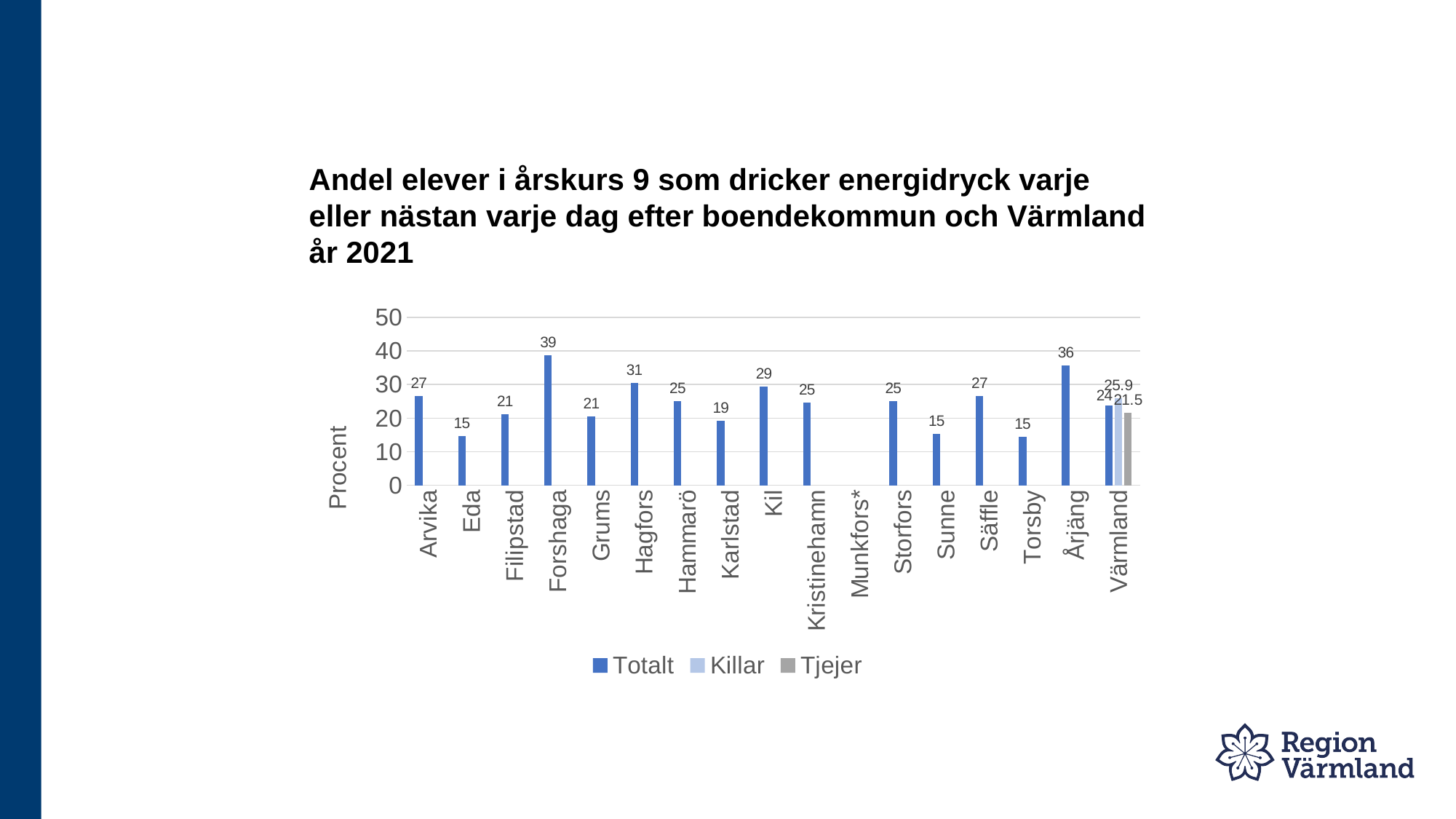
For Värmland, what is the difference between the Killar and Tjejer values? 4.4 What is the difference between the Totalt values for Forshaga and Årjäng? 3 How many series does the legend list? 3 Which has a higher Totalt value, Hagfors or Kil? Hagfors Which municipality has the highest Totalt value? Forshaga What is the label on the vertical axis? Procent What is the Killar value for Värmland? 25.9 What is the Totalt value for Karlstad? 19 What kind of chart is shown on the slide? Bar chart What is the Totalt value for Forshaga? 39 What is the Tjejer value for Värmland? 21.5 How many categories are shown on the x axis? 17